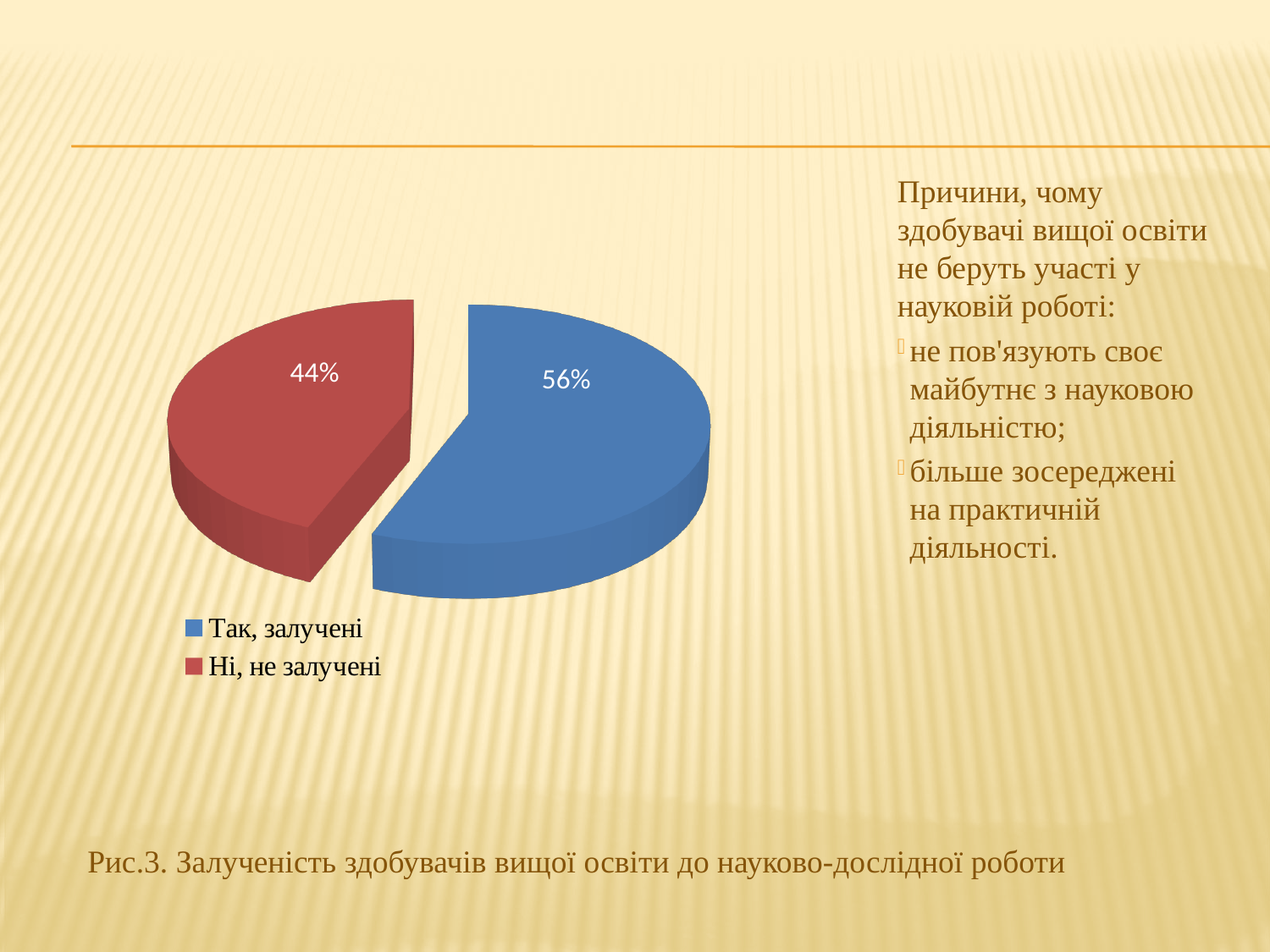
Which category has the smallest share of the pie? Ні, не залучені What kind of chart is shown on the slide? pie chart Which category has the largest share of the pie? Так, залучені What colour is the slice for "Ні, не залучені"? red What is the value for "Так, залучені"? 56% How many entries does the legend list? 2 What is the difference between the shares of "Так, залучені" and "Ні, не залучені"? 12% What is the value for "Ні, не залучені"? 44% How many slices does the pie chart have? 2 Which is larger: the share for "Так, залучені" or for "Ні, не залучені"? Так, залучені Is the share for "Так, залучені" greater or less than 50%? greater What is the caption of the figure below the chart? Рис.3. Залученість здобувачів вищої освіти до науково-дослідної роботи